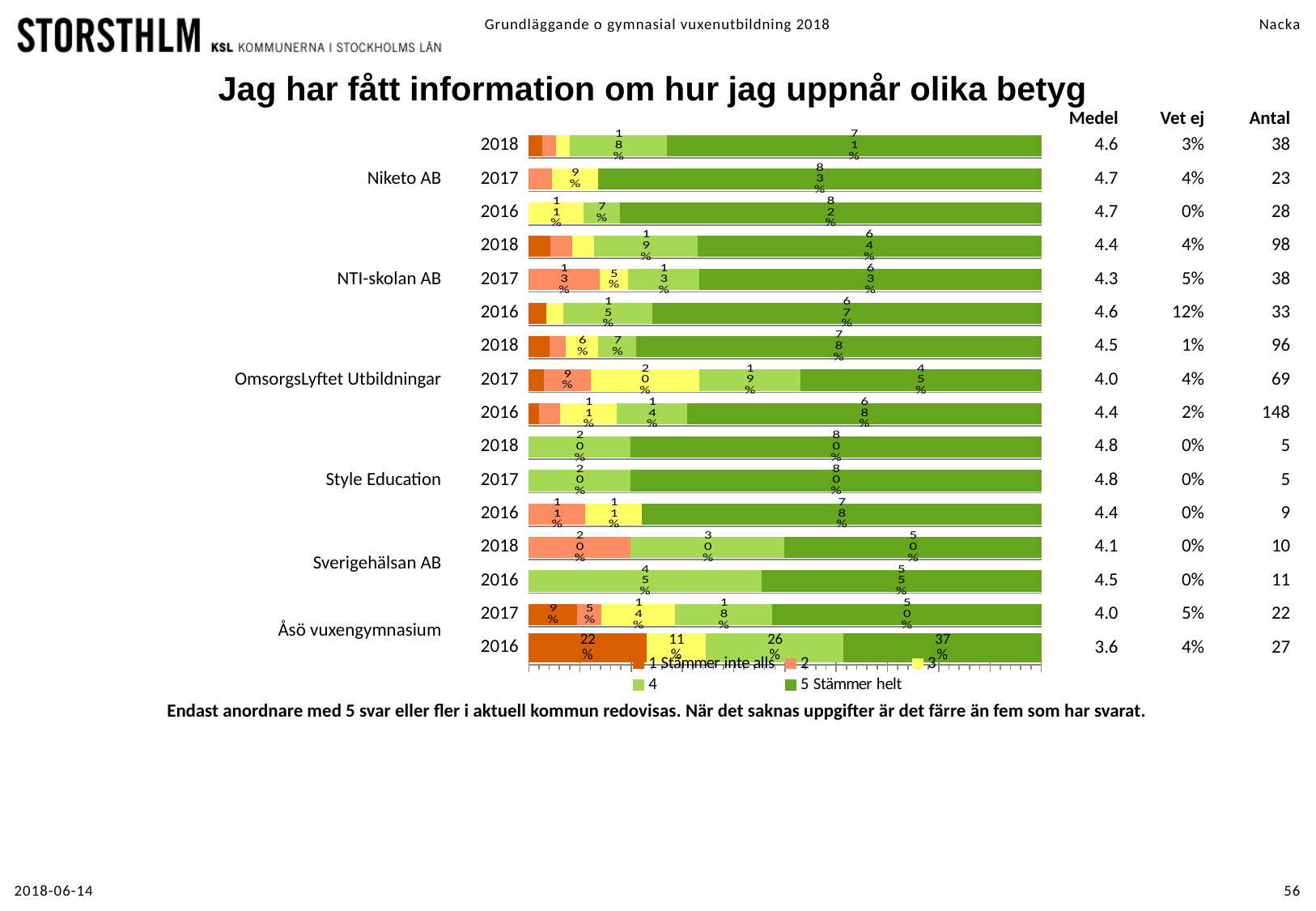
How many bars are plotted in the chart? 16 What percentage of Sverigehälsan AB respondents in 2016 answered "4"? 45% For Åsö vuxengymnasium in 2016, how many percentage points larger is the "5 Stämmer helt" share than the "4" share? 11 percentage points What kind of chart is shown on the slide? Stacked bar chart Which bar has the lowest share of "5 Stämmer helt"? Åsö vuxengymnasium 2016 What percentage of OmsorgsLyftet Utbildningar respondents in 2017 answered "3"? 20% How many series does the legend list? 5 Which has a larger share of "5 Stämmer helt" in 2018: Sverigehälsan AB or Style Education? Style Education What percentage of Style Education respondents in 2018 answered "5 Stämmer helt"? 80% What percentage of Åsö vuxengymnasium respondents in 2016 answered "1 Stämmer inte alls"? 22% What is the legend label for the dark green series? 5 Stämmer helt What percentage of NTI-skolan AB respondents in 2017 answered "2"? 13%